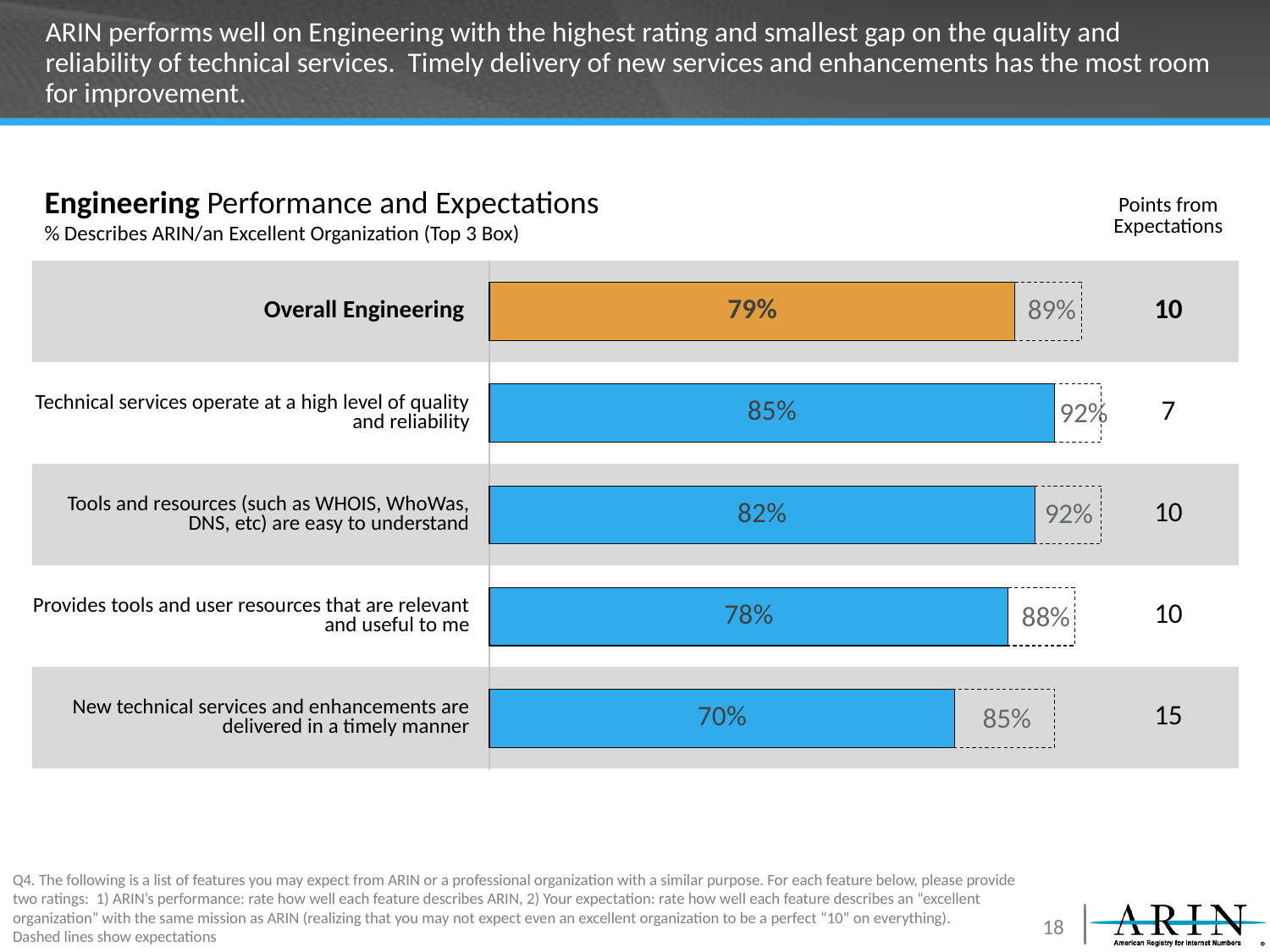
What is the ARIN performance value for Overall Engineering? 79% How many categories are shown in the chart? 5 What kind of chart is shown on the slide? Bar chart What is the difference between the expectation and performance values for "Tools and resources (such as WHOIS, WhoWas, DNS, etc) are easy to understand"? 10 What is the "Points from Expectations" value for "New technical services and enhancements are delivered in a timely manner"? 15 Which category has the highest performance value? Technical services operate at a high level of quality and reliability What is the expectation value for "Provides tools and user resources that are relevant and useful to me"? 88% Which category has the lowest performance value? New technical services and enhancements are delivered in a timely manner What is the performance value for "New technical services and enhancements are delivered in a timely manner"? 70% Which is larger: the performance value for "Technical services operate at a high level of quality and reliability" or for "Provides tools and user resources that are relevant and useful to me"? Technical services operate at a high level of quality and reliability What colour is the Overall Engineering bar? Orange What is the expectation value (dashed bar) for Overall Engineering? 89%